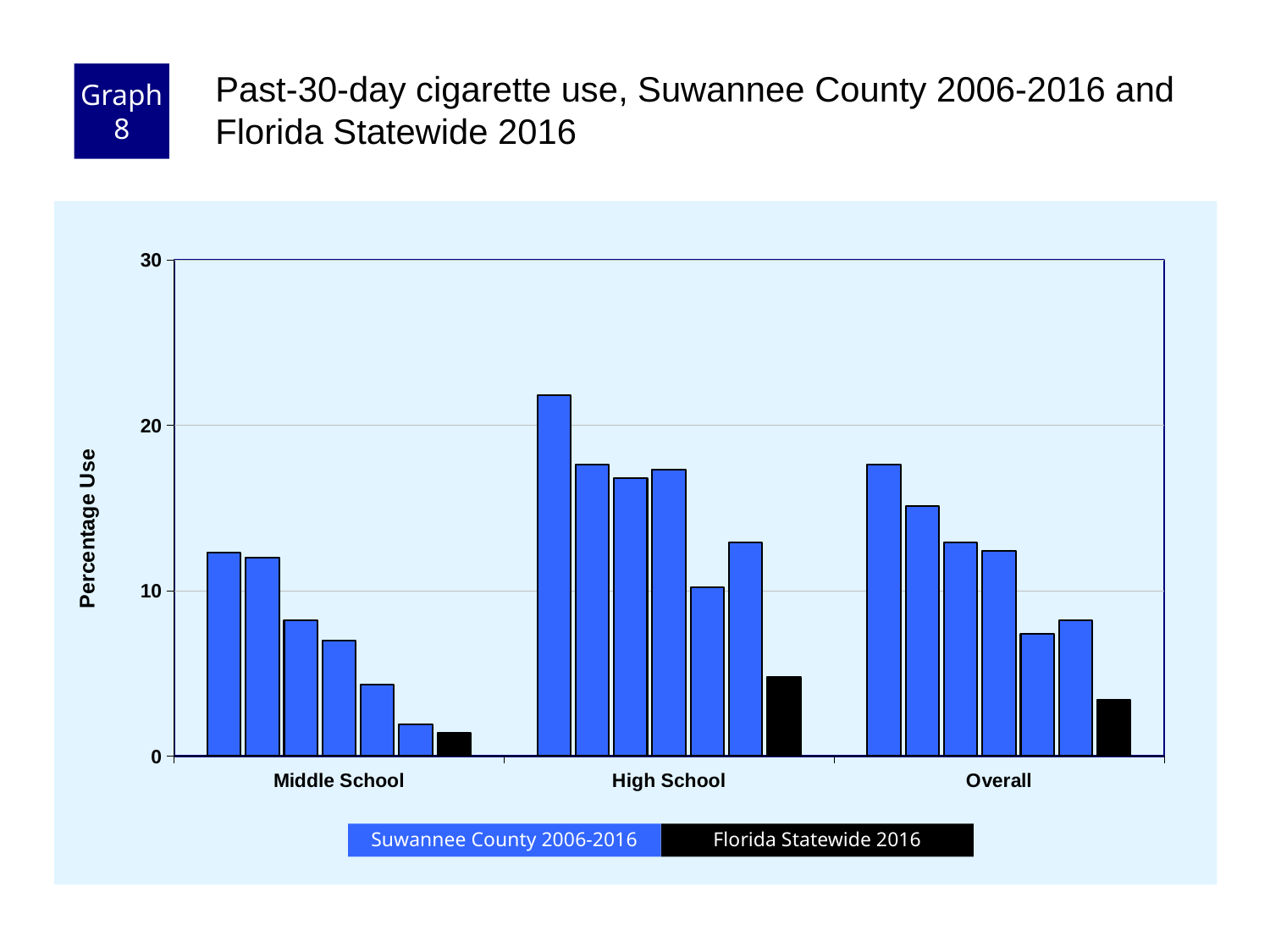
Which category group contains the tallest bar on the chart? High School How many series does the legend list? 2 Is the first Suwannee County 2006-2016 bar for Middle School greater or less than 10? greater Which is larger, the Florida Statewide 2016 value for High School or for Middle School? High School Which is larger, the Florida Statewide 2016 value for Overall or for Middle School? Overall What is the title of the y axis? Percentage Use How many category groups are shown on the x axis? 3 Is the Florida Statewide 2016 value for High School greater or less than 10? less What kind of chart is shown on the slide? bar chart Do the Suwannee County 2006-2016 bars for Middle School rise or fall from left to right? fall Is the tallest Suwannee County 2006-2016 bar for High School greater or less than 20? greater How many Suwannee County 2006-2016 bars are shown in each category group? 6